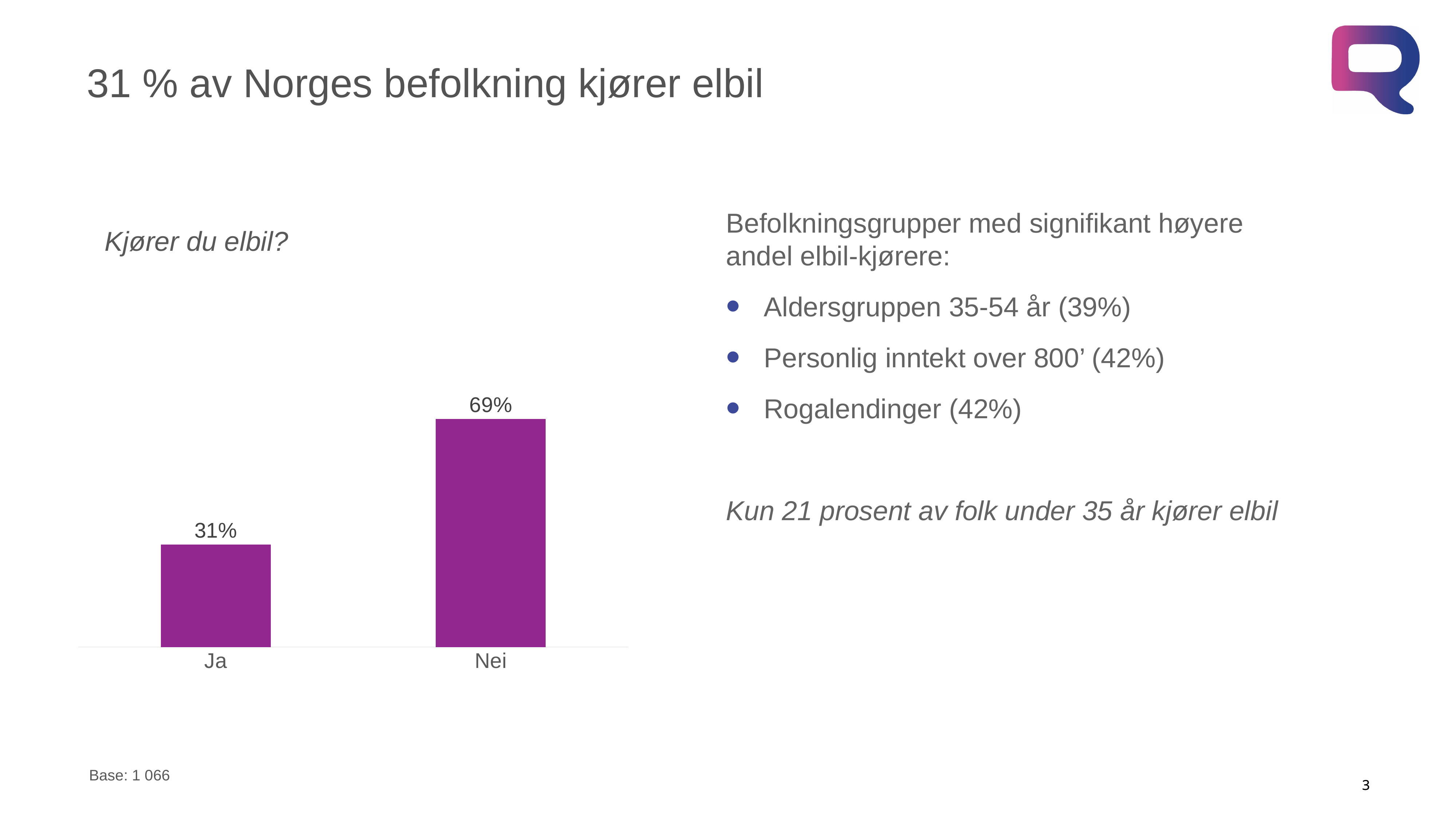
What is the total of the values for Ja and Nei? 100% What is the value for Nei? 69% Which category has the lowest value? Ja What is the value for Ja? 31% How many categories are shown in the chart? 2 What is the difference between the values for Nei and Ja? 38% What question does the chart title ask? Kjører du elbil? What kind of chart is shown on the slide? Bar chart Which is larger, the value for Ja or the value for Nei? Nei What colour are the bars in the chart? Purple Which category has the highest value? Nei